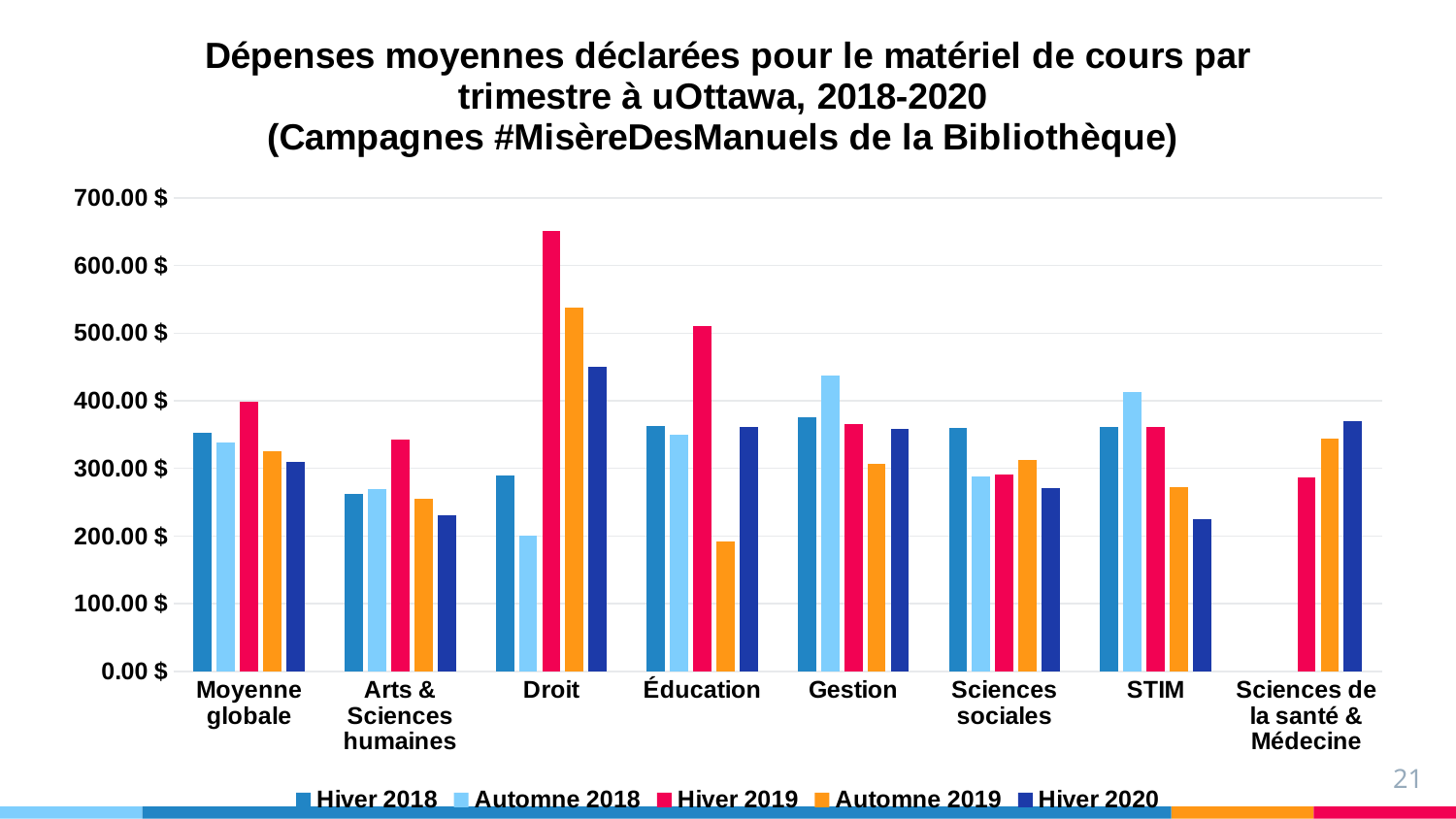
Which series has the highest value for Moyenne globale? Hiver 2019 For Droit, which is larger: the Hiver 2019 value or the Automne 2018 value? Hiver 2019 Which series has the lowest value for Droit? Automne 2018 Which category has the highest value for Hiver 2019? Droit Is the Hiver 2020 value for STIM greater or less than 300.00 $? less How many categories are shown along the x axis? 8 How many series does the legend list? 5 Is the Automne 2018 value for Gestion greater or less than 400.00 $? greater Which is larger: the Hiver 2019 value for Éducation or the Hiver 2019 value for Gestion? Éducation What kind of chart is shown on the slide? Bar chart Is the Hiver 2019 value for Droit greater or less than 600.00 $? greater